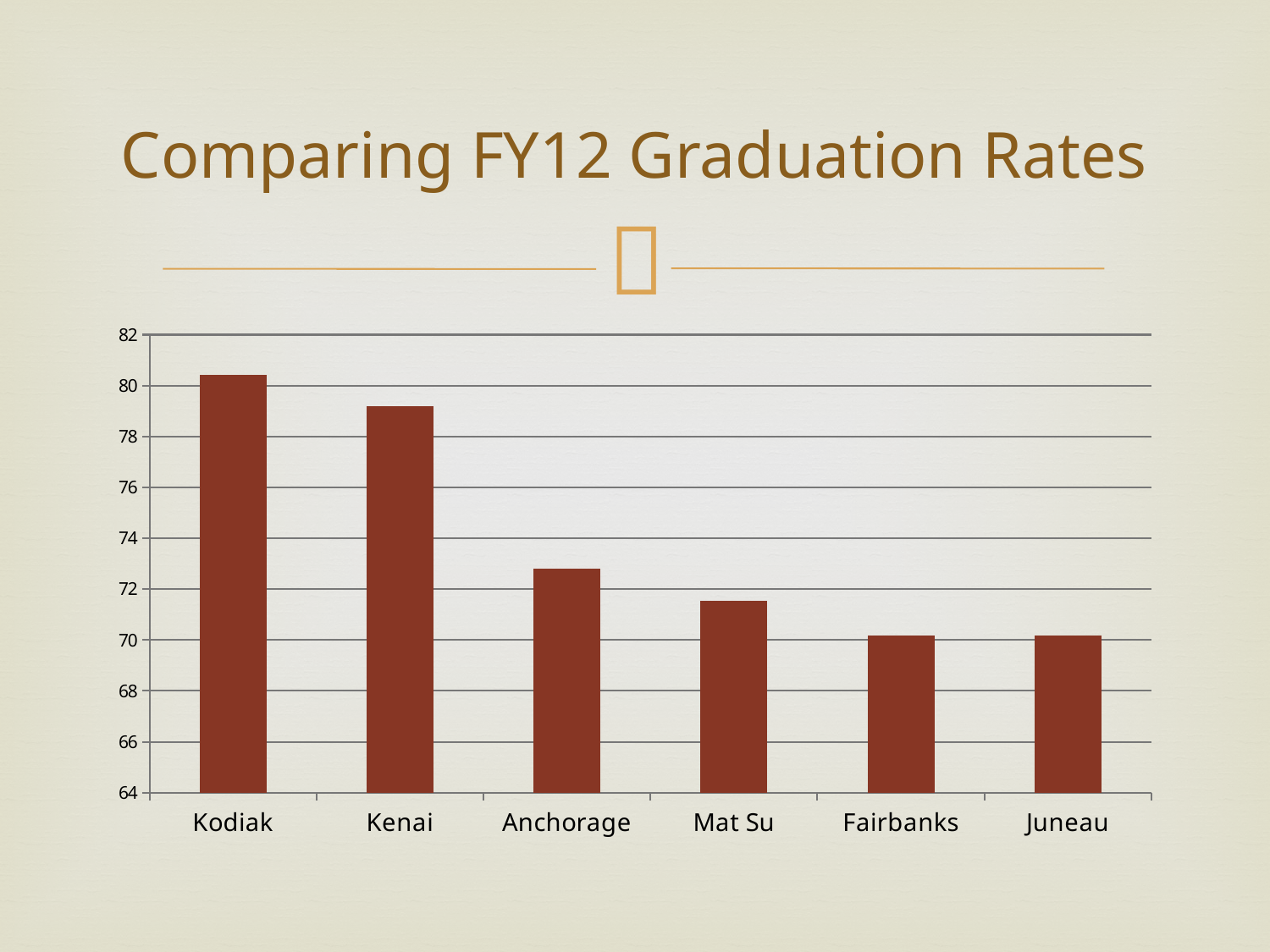
What is the title of the chart on the slide? Comparing FY12 Graduation Rates Is the value for Kenai greater or less than 80? less Is the value for Anchorage greater or less than 74? less Which is larger, the value for Mat Su or the value for Kodiak? Kodiak Is the value for Mat Su greater or less than 72? less What kind of chart is shown on the slide? bar chart How many districts are shown on the x axis of the chart? 6 Do the graduation rates generally rise or fall moving from left to right across the chart? fall Which district has the highest graduation rate in the chart? Kodiak Which is larger, the value for Kenai or the value for Anchorage? Kenai